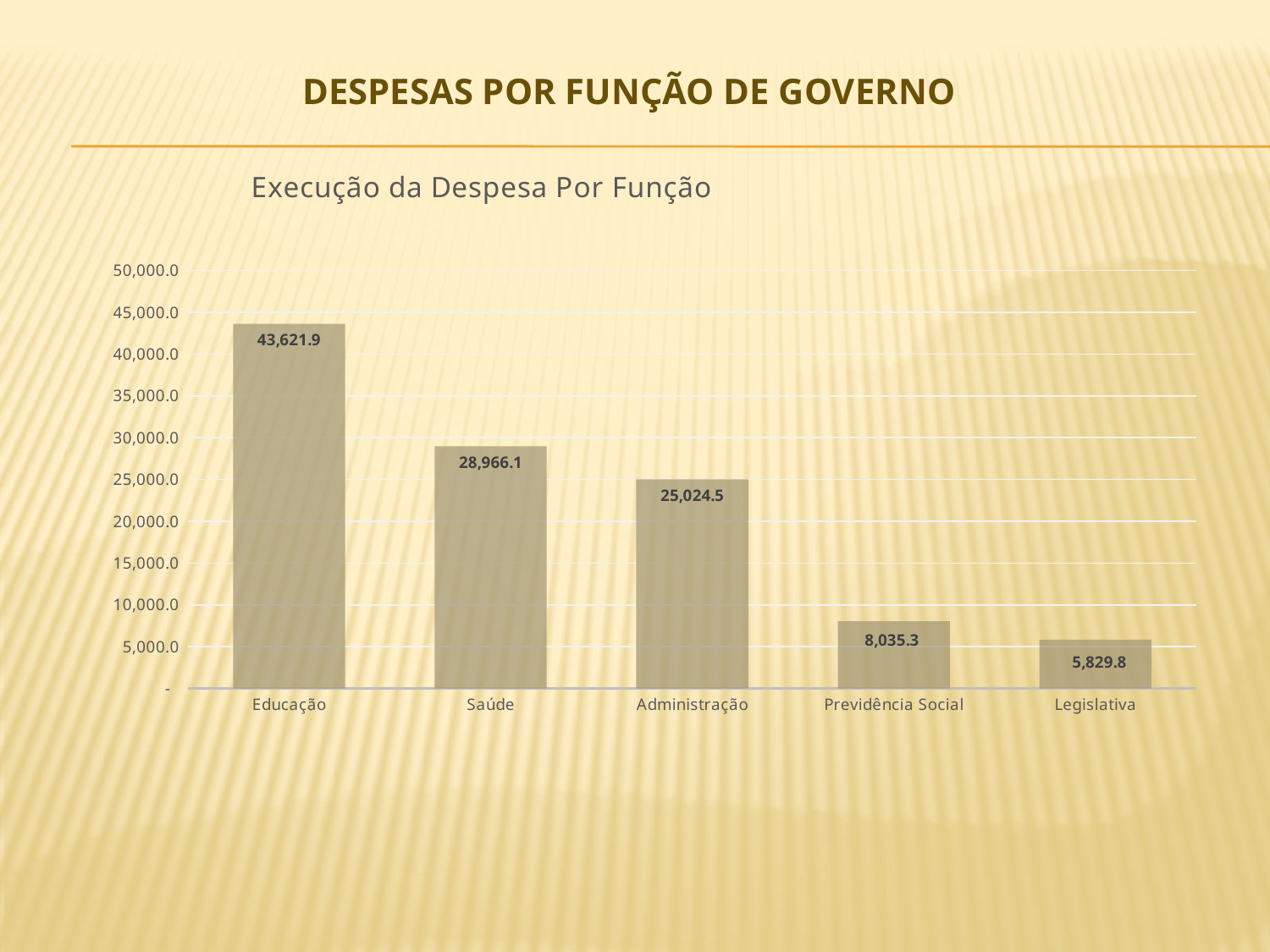
What is the value for Previdência Social? 8,035.3 What kind of chart is shown? Bar chart What is the difference between the values for Previdência Social and Legislativa? 2,205.5 What is the value for Legislativa? 5,829.8 Which category has the highest value? Educação Do the values rise or fall from left to right along the x axis? Fall What is the value for Saúde? 28,966.1 Which is larger, the value for Saúde or the value for Administração? Saúde How many categories are shown on the x axis? 5 What is the difference between the values for Educação and Saúde? 14,655.8 What is the value for Educação? 43,621.9 Which category has the lowest value? Legislativa